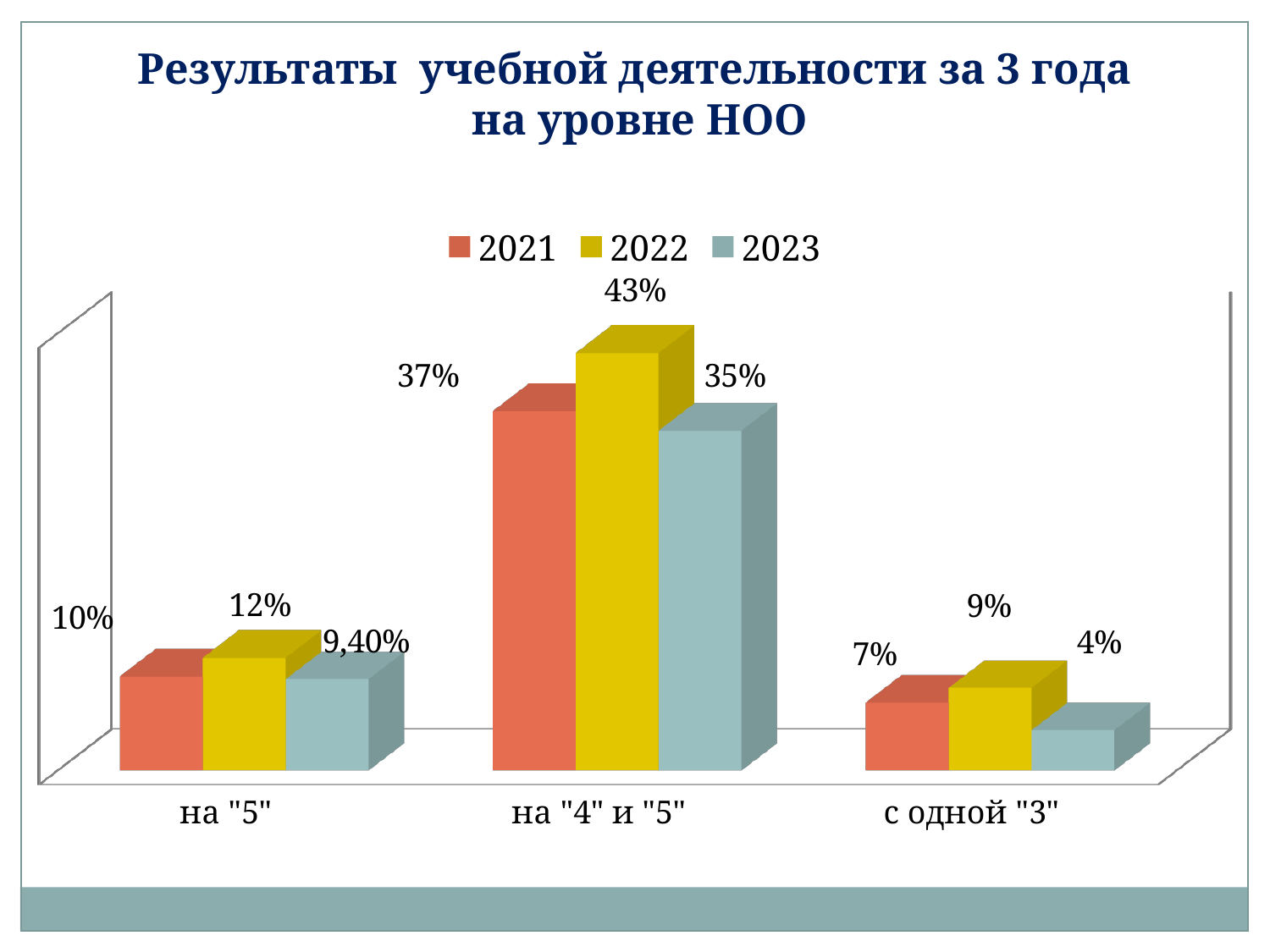
What kind of chart is shown on the slide? bar chart How many series does the legend list? 3 What is the difference between the 2022 and 2021 values in the category на "4" и "5"? 6% What is the value for 2023 in the category на "5"? 9,40% What is the value for 2022 in the category на "4" и "5"? 43% What is the title of the chart? Результаты учебной деятельности за 3 года на уровне НОО Which year has the lowest value in the category с одной "3"? 2023 What is the value for 2021 in the category с одной "3"? 7% Which is larger: the 2021 value or the 2023 value in the category на "4" и "5"? 2021 How many categories are shown on the x axis? 3 What is the difference between the 2022 and 2023 values in the category с одной "3"? 5% Which year has the highest value in the category на "4" и "5"? 2022